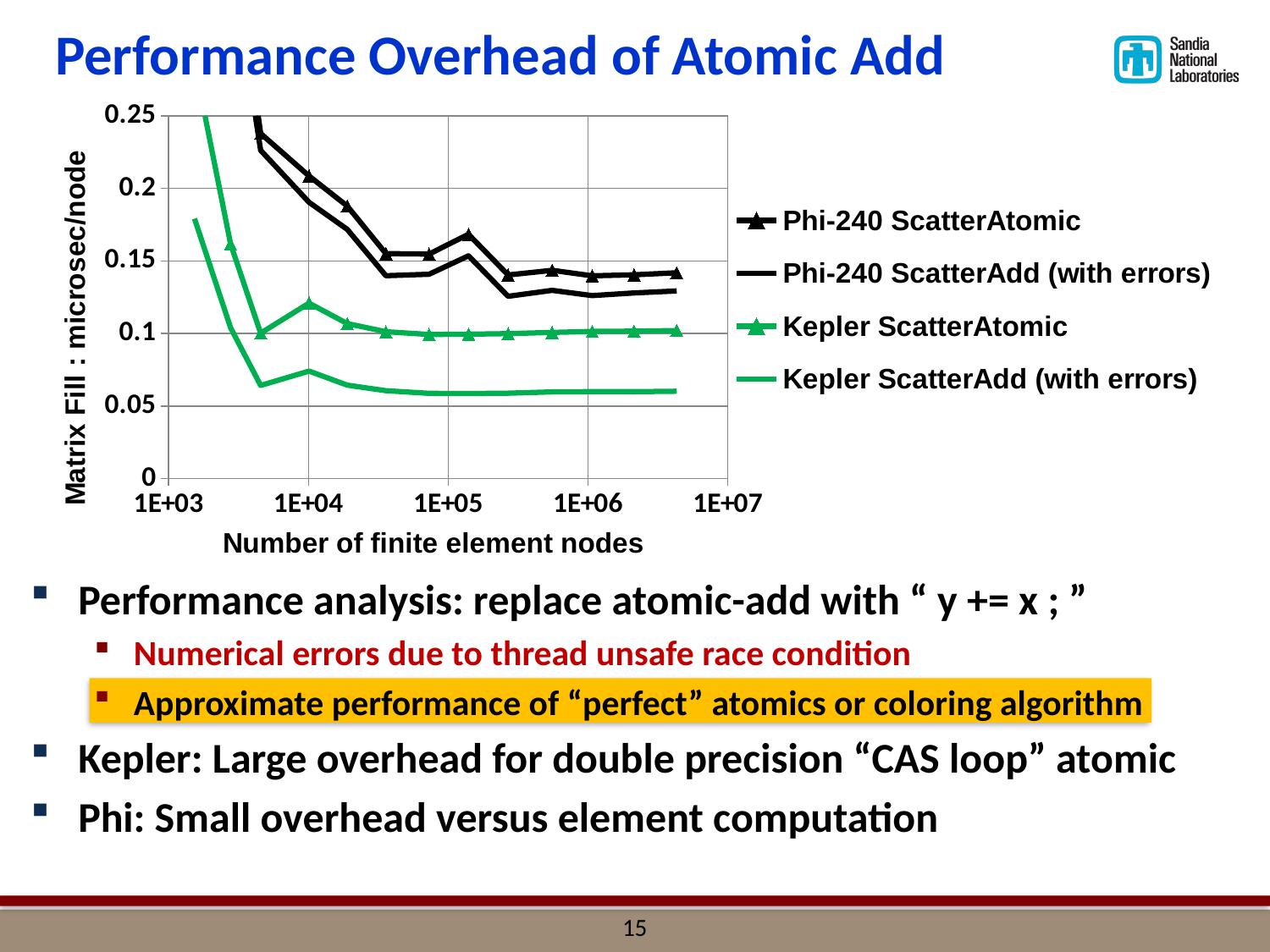
Does the Phi-240 ScatterAtomic series generally rise or fall as the number of finite element nodes increases? fall Is the value for Kepler ScatterAdd (with errors) at 1E+06 nodes greater or less than 0.1? less Is the value for Phi-240 ScatterAtomic at 1E+06 nodes greater or less than 0.1? greater Is the value for Phi-240 ScatterAtomic at 1E+06 nodes greater or less than 0.15? less Which series has the lowest value at 1E+06 nodes? Kepler ScatterAdd (with errors) How many series does the legend list? 4 What kind of chart is shown on the slide? line chart What is the y-axis title of the chart? Matrix Fill : microsec/node What is the x-axis title of the chart? Number of finite element nodes At 1E+06 nodes, which is larger: Kepler ScatterAtomic or Kepler ScatterAdd (with errors)? Kepler ScatterAtomic Which series has the highest value at 1E+06 nodes? Phi-240 ScatterAtomic